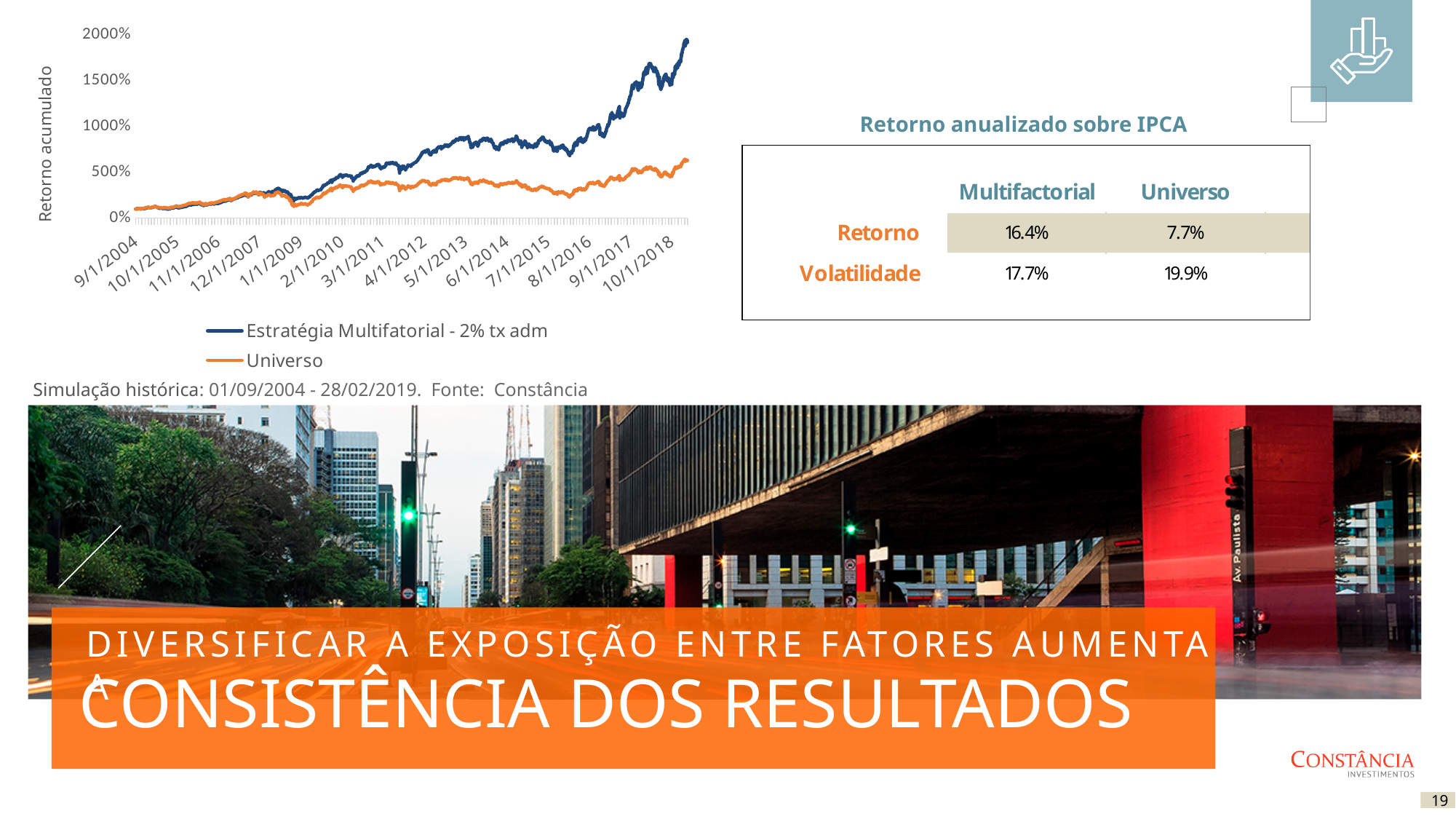
Does the Universo series ever rise above 1000% on the chart? no What is the highest value shown on the chart's vertical axis? 2000% Overall, do the values of the Estratégia Multifatorial series rise or fall from 9/1/2004 to 10/1/2018? rise Is the value of the Universo series at the end of the chart greater or less than 1000%? less Which series is higher at the right end of the chart (10/1/2018), Estratégia Multifatorial or Universo? Estratégia Multifatorial What kind of chart is shown on the slide? line chart What is the label of the chart's vertical axis? Retorno acumulado How many date labels are shown along the chart's x axis? 14 How many series does the chart legend list? 2 Does the Estratégia Multifatorial series ever rise above 1000% on the chart? yes What are the two series named in the chart legend? Estratégia Multifatorial - 2% tx adm and Universo